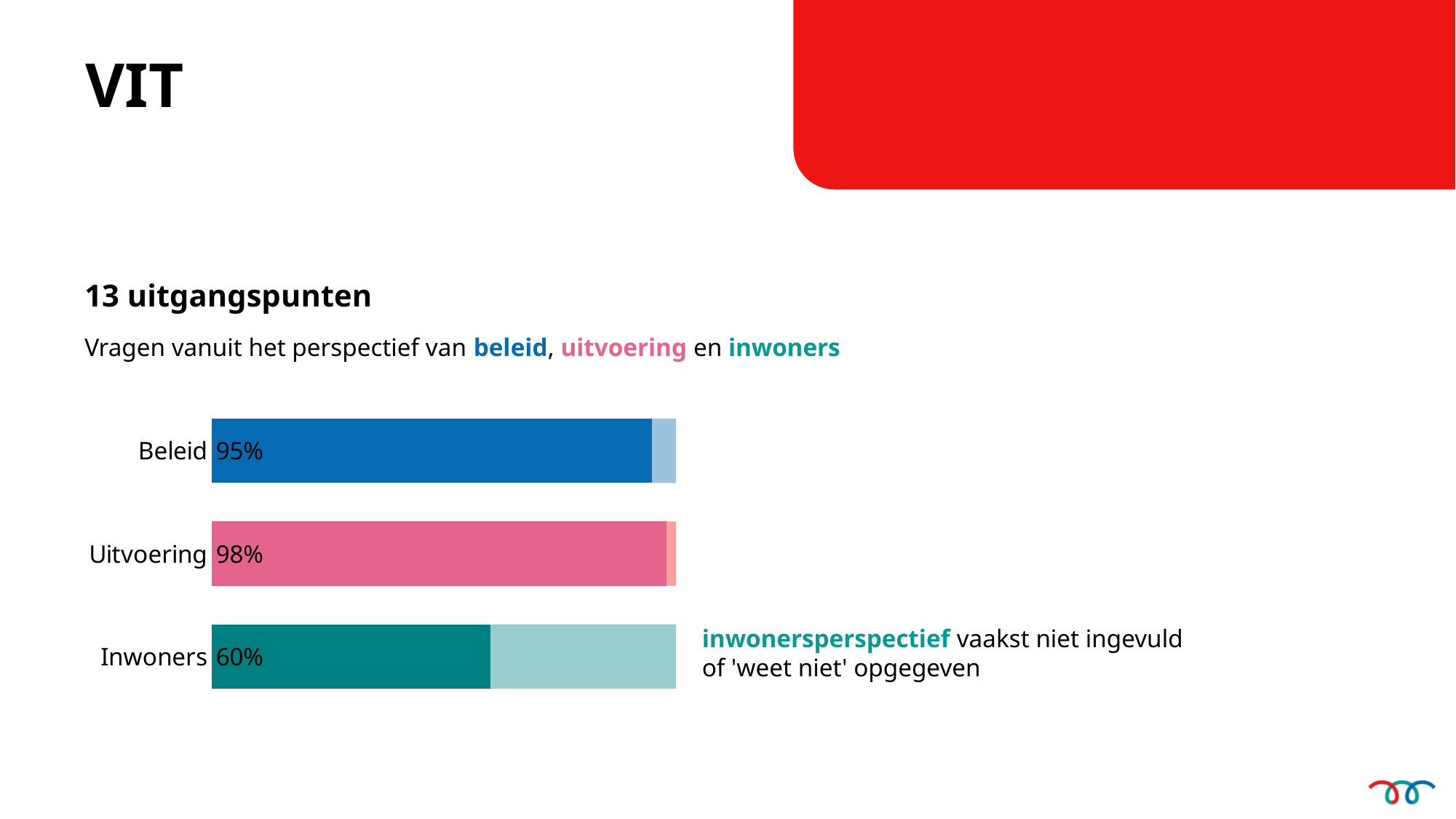
What is the difference between the percentages for Uitvoering and Beleid? 3 percentage points What percentage is shown for Beleid? 95% What colour is the bar for Inwoners? Teal According to the note next to the chart, which perspective was most often not filled in or answered with 'weet niet'? inwonersperspectief What percentage is shown for Inwoners? 60% What kind of chart is shown on the slide? Bar chart What percentage is shown for Uitvoering? 98% How many categories are shown in the chart? 3 Which category has the highest percentage? Uitvoering Which is larger, the percentage for Beleid or for Inwoners? Beleid What is the difference between the percentages for Beleid and Inwoners? 35 percentage points Which category has the lowest percentage? Inwoners